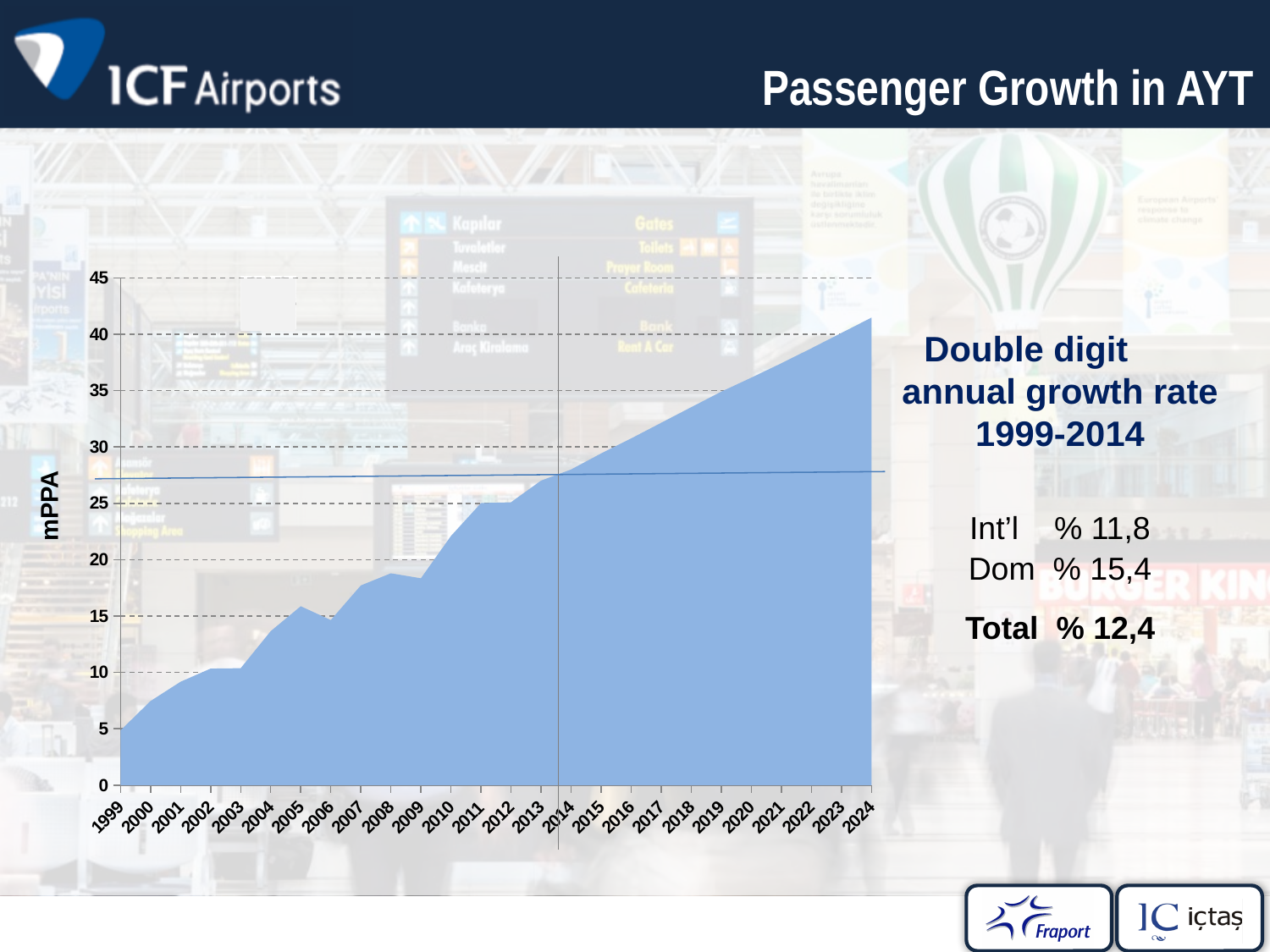
Is the value for 2024 greater or less than 35? greater Is the value for 1999 greater or less than 10? less Is the value for 2009 greater or less than 20? less What kind of chart is shown on the slide? area chart Which year has the highest value in the chart? 2024 How many years are plotted along the x axis of the chart? 26 What is the label on the y axis of the chart? mPPA Which year has the lowest value in the chart? 1999 Do the values generally rise or fall from 1999 to 2024? rise Which year has the larger value, 2005 or 2011? 2011